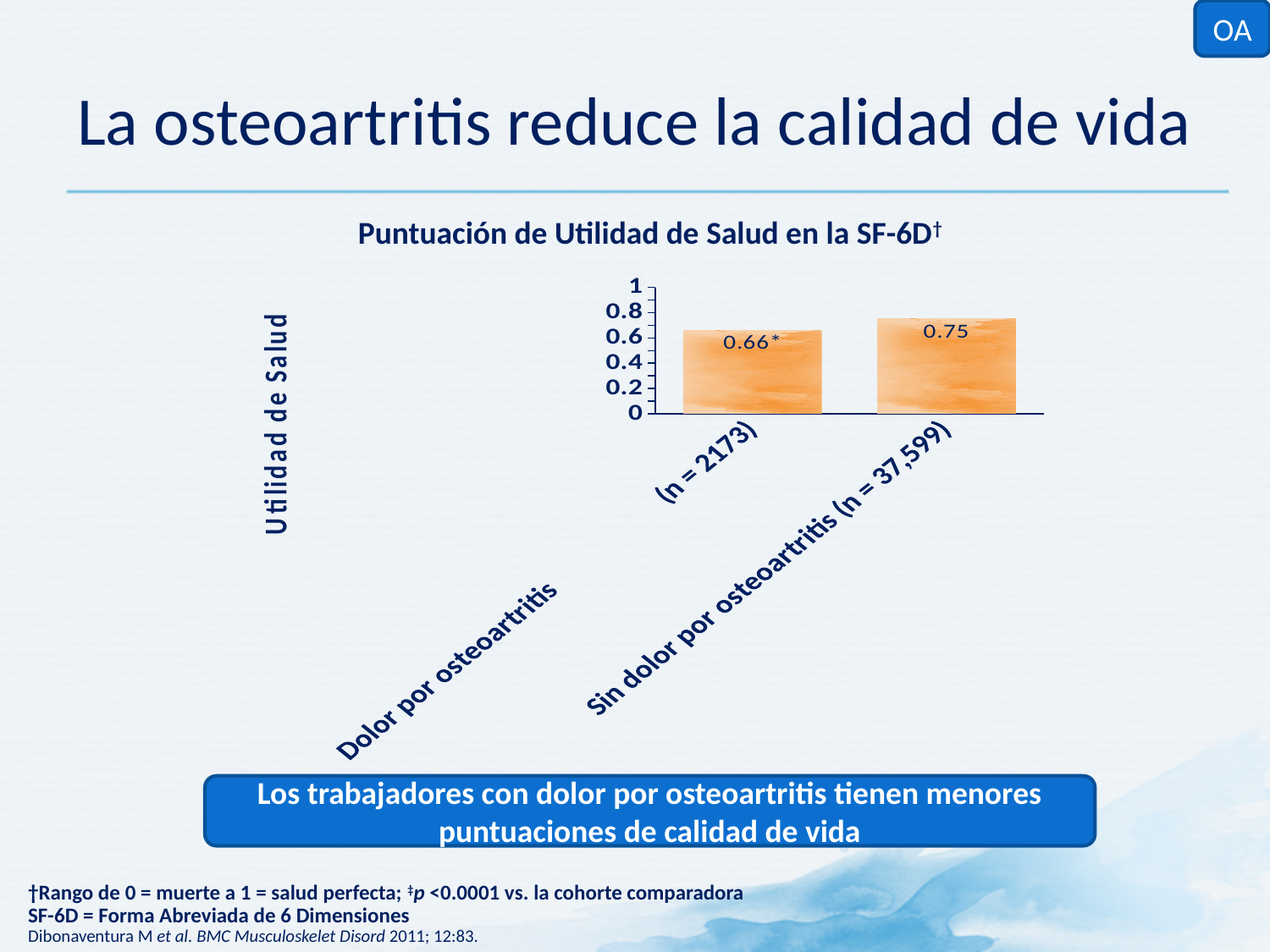
What is the label of the vertical axis of the chart? Utilidad de Salud What type of chart is shown on the slide? Bar chart Is the health utility score for the group with osteoarthritis pain greater or less than 0.8? less How many bars are shown in the chart? 2 What is the SF-6D health utility score for the group with osteoarthritis pain (Dolor por osteoartritis)? 0.66 What is the maximum value shown on the vertical axis? 1 Is the health utility score for the group without osteoarthritis pain greater or less than 0.6? greater What is the difference between the health utility scores of the two groups? 0.09 Which group has the higher health utility score? Sin dolor por osteoartritis What is the sample size (n) for the group with osteoarthritis pain? 2173 What is the SF-6D health utility score for the group without osteoarthritis pain (Sin dolor por osteoartritis)? 0.75 Which group has the lower health utility score? Dolor por osteoartritis